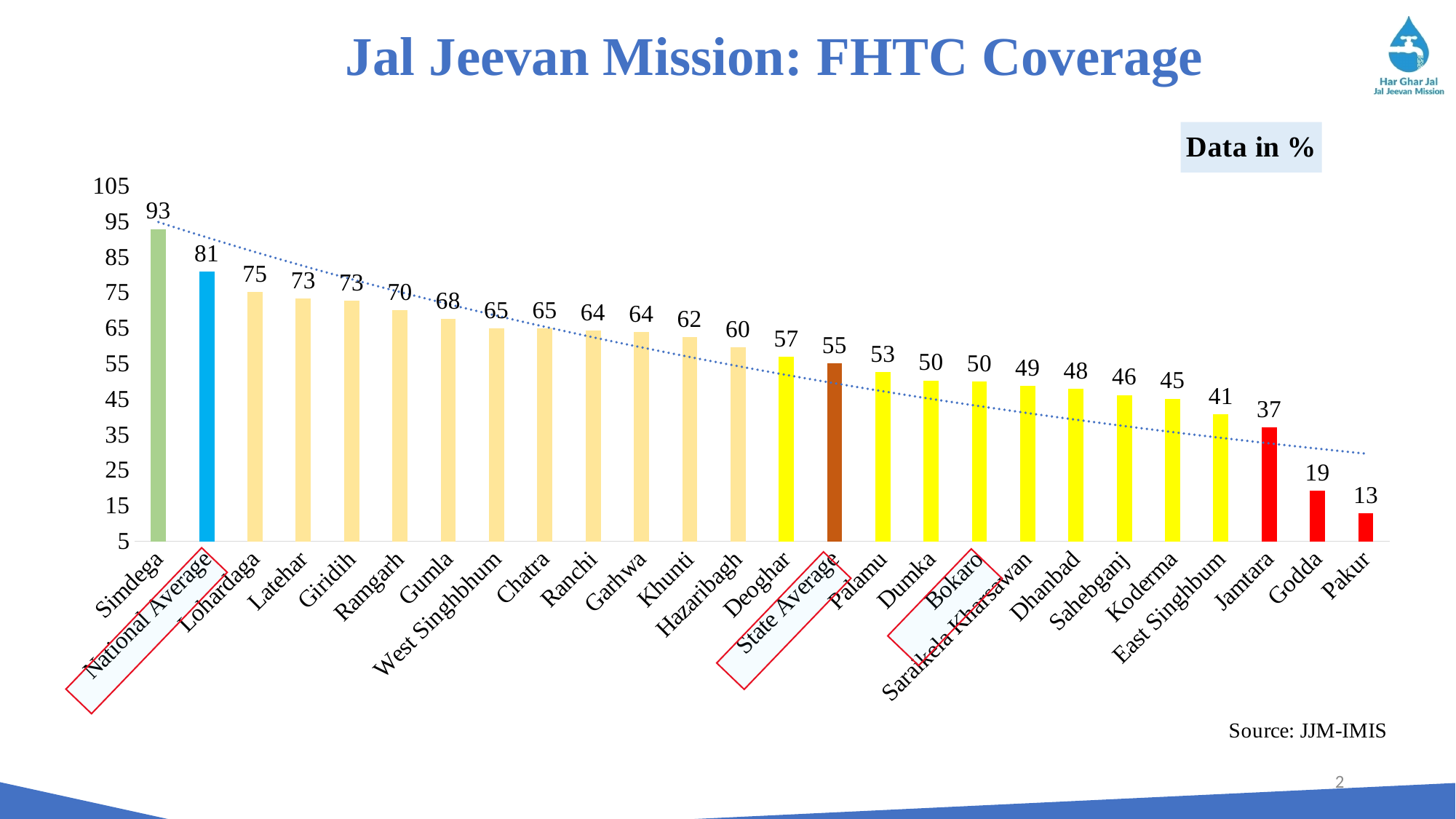
What is the FHTC coverage value for Ranchi? 64 What is the value shown for the National Average? 81 Which category has the highest value on the chart? Simdega What kind of chart is shown on the slide? Bar chart How many bars are plotted on the chart? 26 Which has a larger value, Jamtara or Godda? Jamtara What is the FHTC coverage value for Simdega? 93 Which category has the lowest value on the chart? Pakur What is the difference between the National Average and the State Average values? 26 Do the values rise or fall moving from left to right along the x axis? Fall What is the value shown for the State Average? 55 What unit are the data on the chart expressed in, according to the label on the slide? %